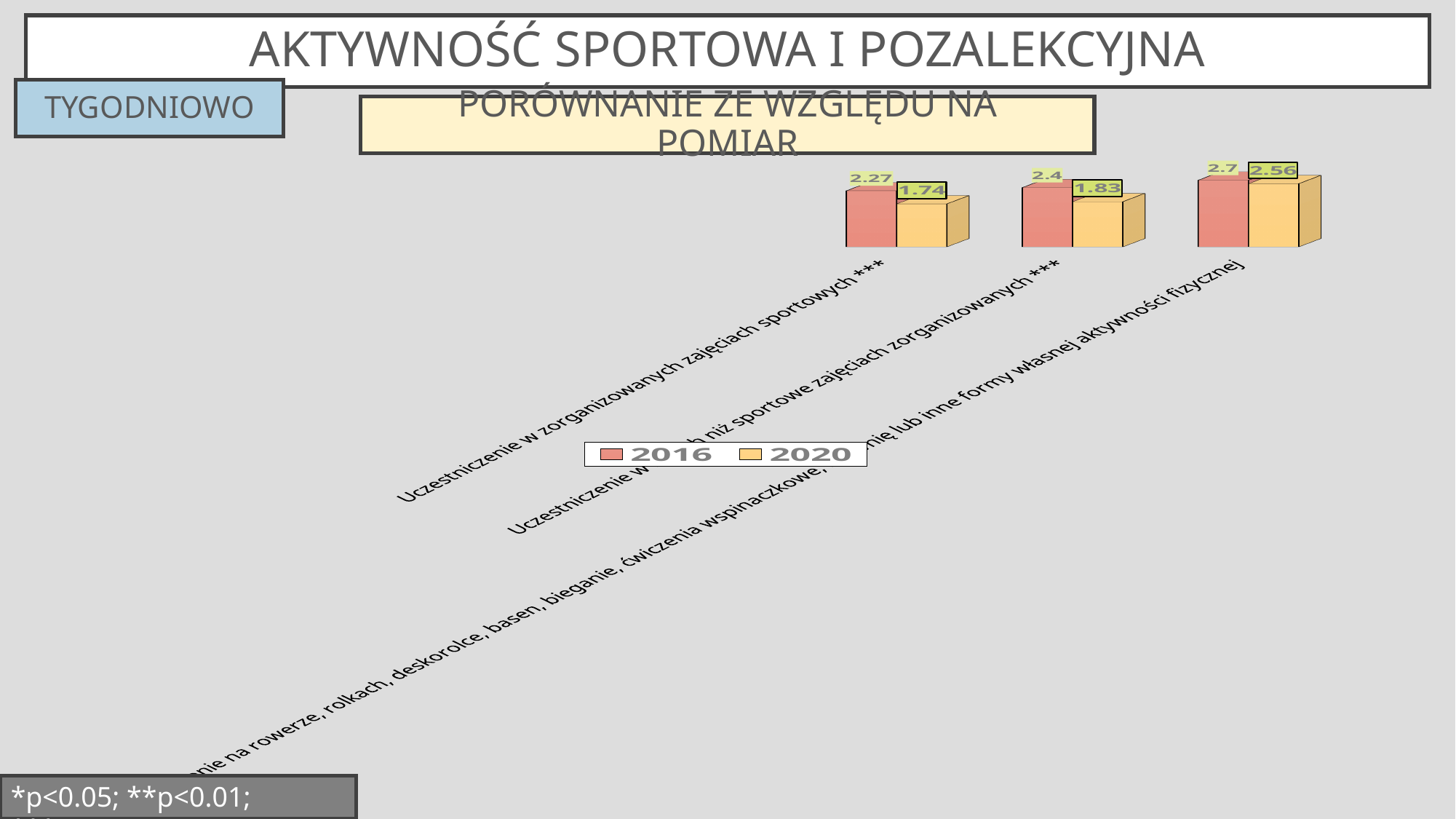
What is the 2020 value for 'Uczestniczenie w zorganizowanych zajęciach sportowych'? 1.74 What is the 2016 value for the second category (zajęcia zorganizowane inne niż sportowe)? 2.4 How many categories are plotted in the chart? 3 What type of chart is shown on the slide? bar chart Which two years are listed in the chart legend? 2016 and 2020 What is the 2020 value for the third category (własna aktywność fizyczna)? 2.56 Which category has the highest 2016 value? the third category (inne formy własnej aktywności fizycznej) Which category has the lowest 2020 value? Uczestniczenie w zorganizowanych zajęciach sportowych How many series does the chart legend list? 2 What is the difference between the 2016 and 2020 values for 'Uczestniczenie w zorganizowanych zajęciach sportowych'? 0.53 For the second category, is the 2016 value or the 2020 value larger? 2016 What is the 2016 value for 'Uczestniczenie w zorganizowanych zajęciach sportowych'? 2.27